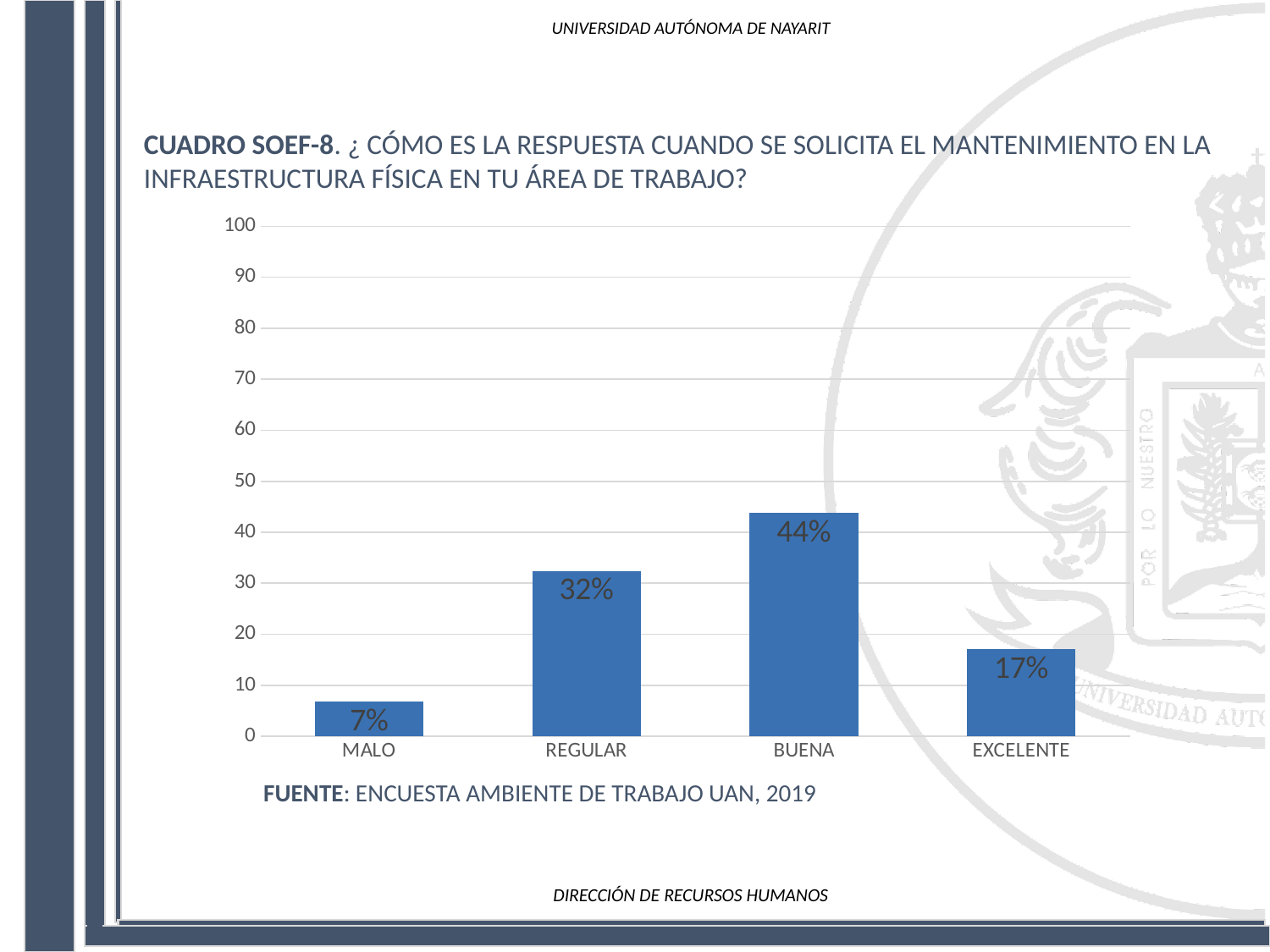
What is the value for MALO? 7% How many categories are shown on the x axis? 4 What is the value for REGULAR? 32% What is the difference between the values for EXCELENTE and MALO? 10% Which is larger, the value for REGULAR or the value for EXCELENTE? REGULAR What is the value for EXCELENTE? 17% What is the value for BUENA? 44% Which category has the lowest value? MALO Is the value for BUENA greater or less than 40? greater What is the difference between the values for BUENA and REGULAR? 12% What kind of chart is shown on the slide? bar chart Which category has the highest value? BUENA